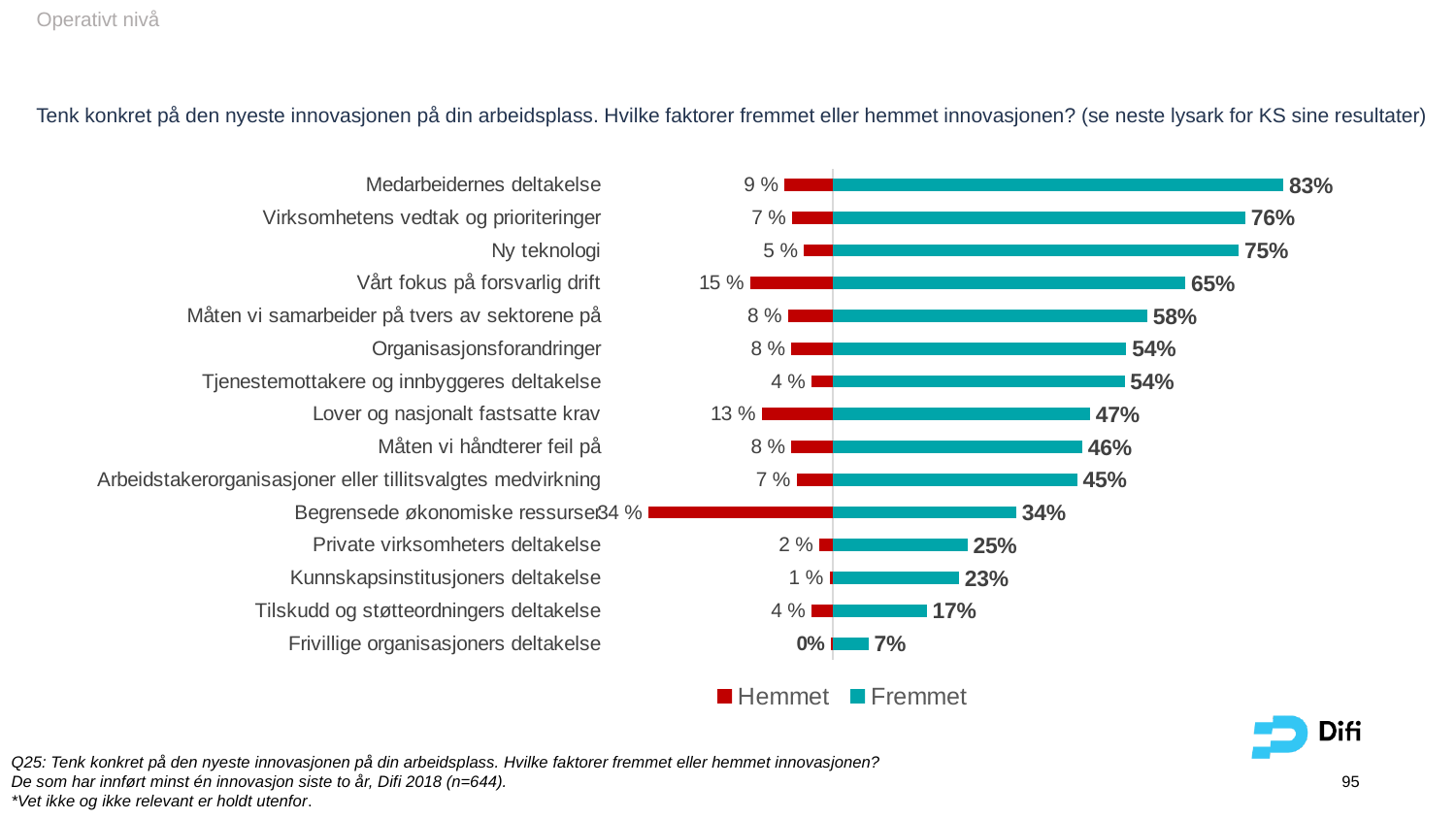
What is the Fremmet value for Frivillige organisasjoners deltakelse? 7% Which is larger, the Fremmet value for Lover og nasjonalt fastsatte krav or for Måten vi håndterer feil på? Lover og nasjonalt fastsatte krav Which category has the highest Hemmet value? Begrensede økonomiske ressurser What is the Hemmet value for Begrensede økonomiske ressurser? 34 % What is the Fremmet value for Medarbeidernes deltakelse? 83% How many categories are shown in the chart? 15 What is the difference between the Fremmet values for Ny teknologi and Vårt fokus på forsvarlig drift? 10 percentage points What kind of chart is shown on the slide? Bar chart Which category has the highest Fremmet value? Medarbeidernes deltakelse How many series does the legend list? 2 What is the Hemmet value for Vårt fokus på forsvarlig drift? 15 % Which category has the lowest Fremmet value? Frivillige organisasjoners deltakelse